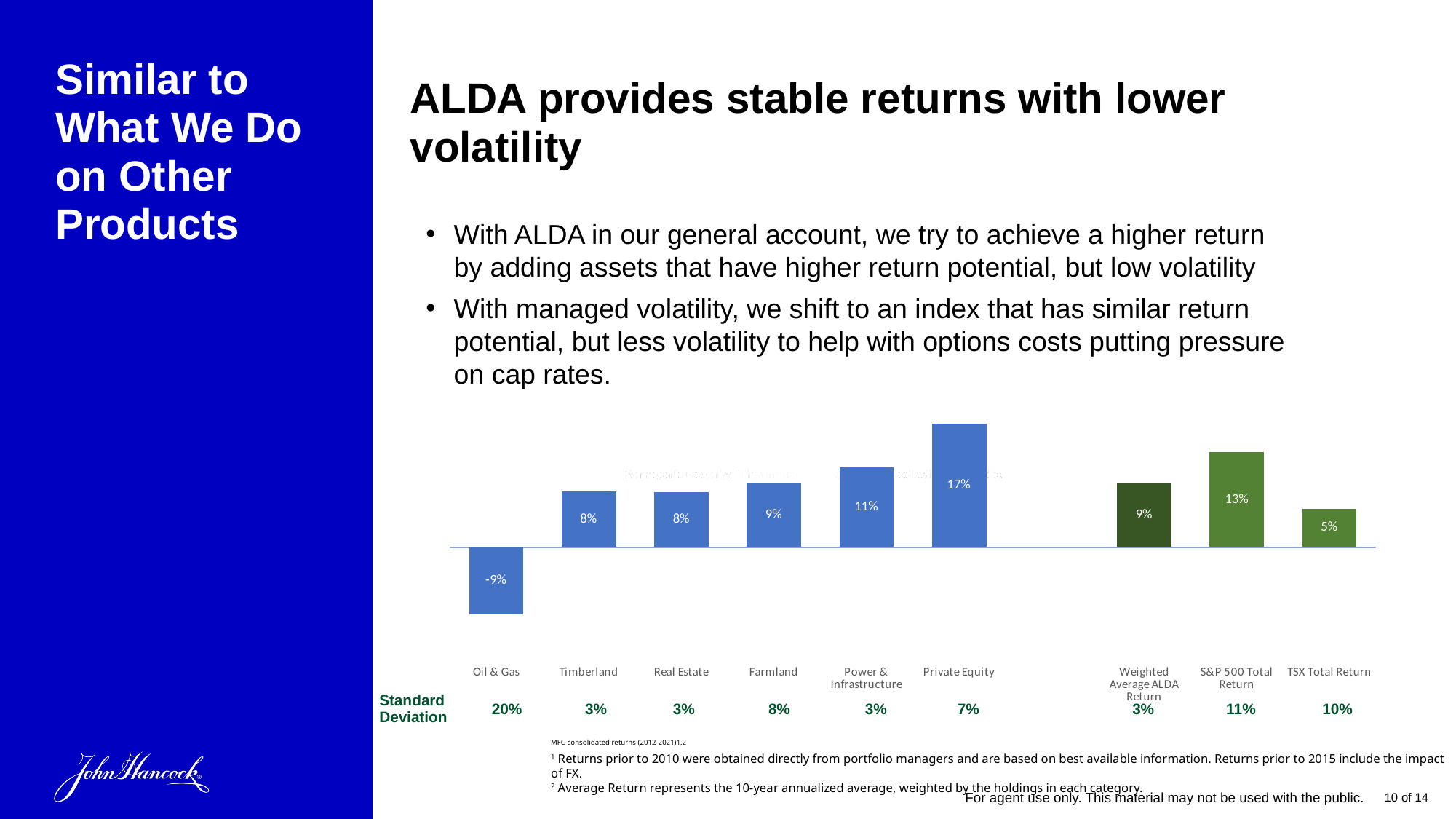
What is the return shown for the Weighted Average ALDA Return bar? 9% What kind of chart is shown on the slide? Bar chart Which has a higher return, S&P 500 Total Return or TSX Total Return? S&P 500 Total Return What is the return shown for the S&P 500 Total Return bar? 13% What is the return shown for Oil & Gas? -9% Which category has the lowest return in the chart? Oil & Gas What is the Standard Deviation listed for the S&P 500 Total Return? 11% What is the difference between the Private Equity return and the Power & Infrastructure return? 6% What is the return shown for Private Equity? 17% What is the Standard Deviation listed for Oil & Gas? 20% How many bars are plotted in the chart? 9 Which category has the highest return in the chart? Private Equity